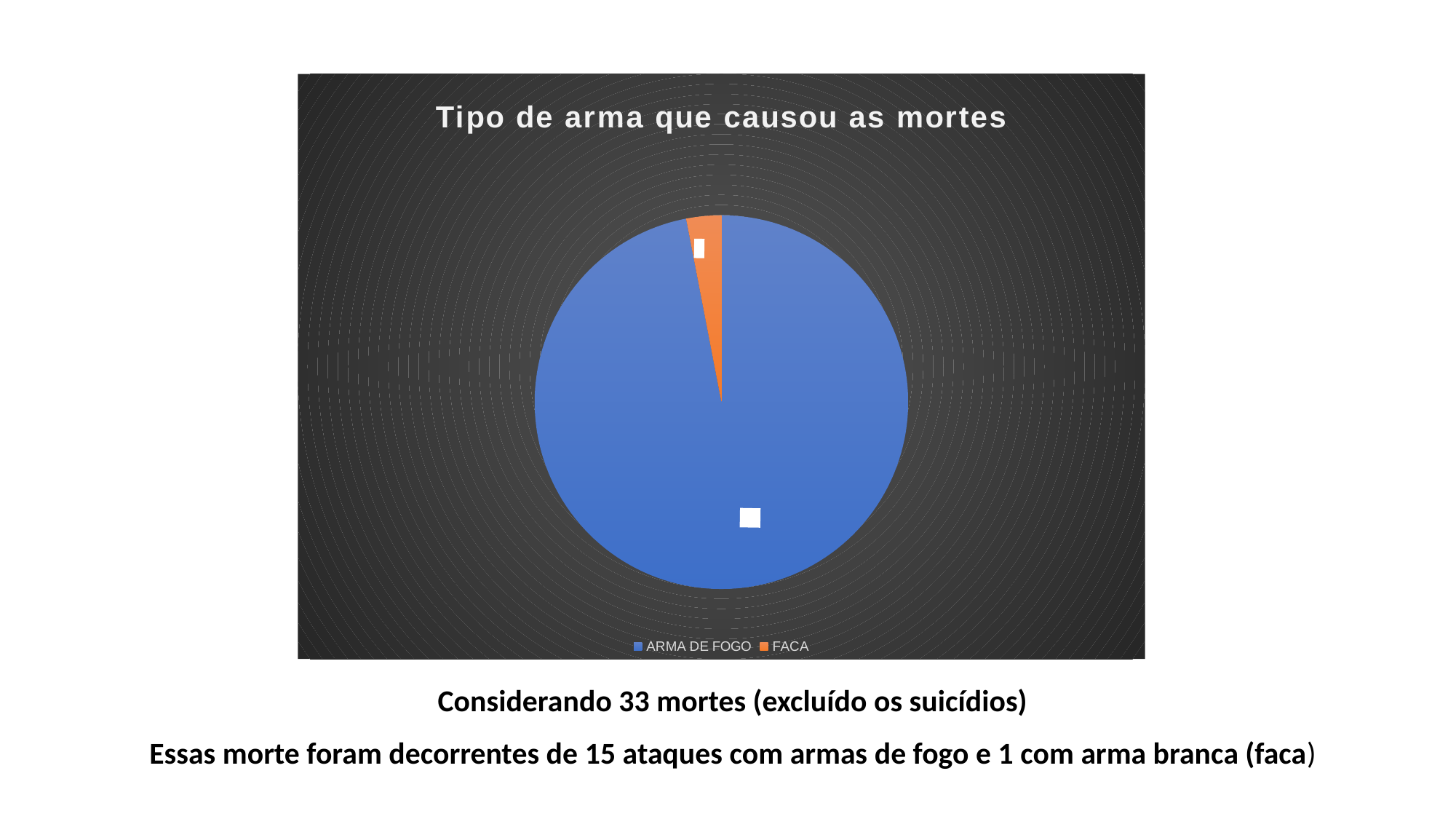
Which category has the largest slice of the pie? ARMA DE FOGO What colour is the FACA slice in the pie chart? orange Which category has the smallest slice of the pie? FACA Which slice is larger, ARMA DE FOGO or FACA? ARMA DE FOGO What is the title of the chart? Tipo de arma que causou as mortes What kind of chart is shown on the slide? pie chart How many entries does the chart legend list? 2 How many slices does the pie chart have? 2